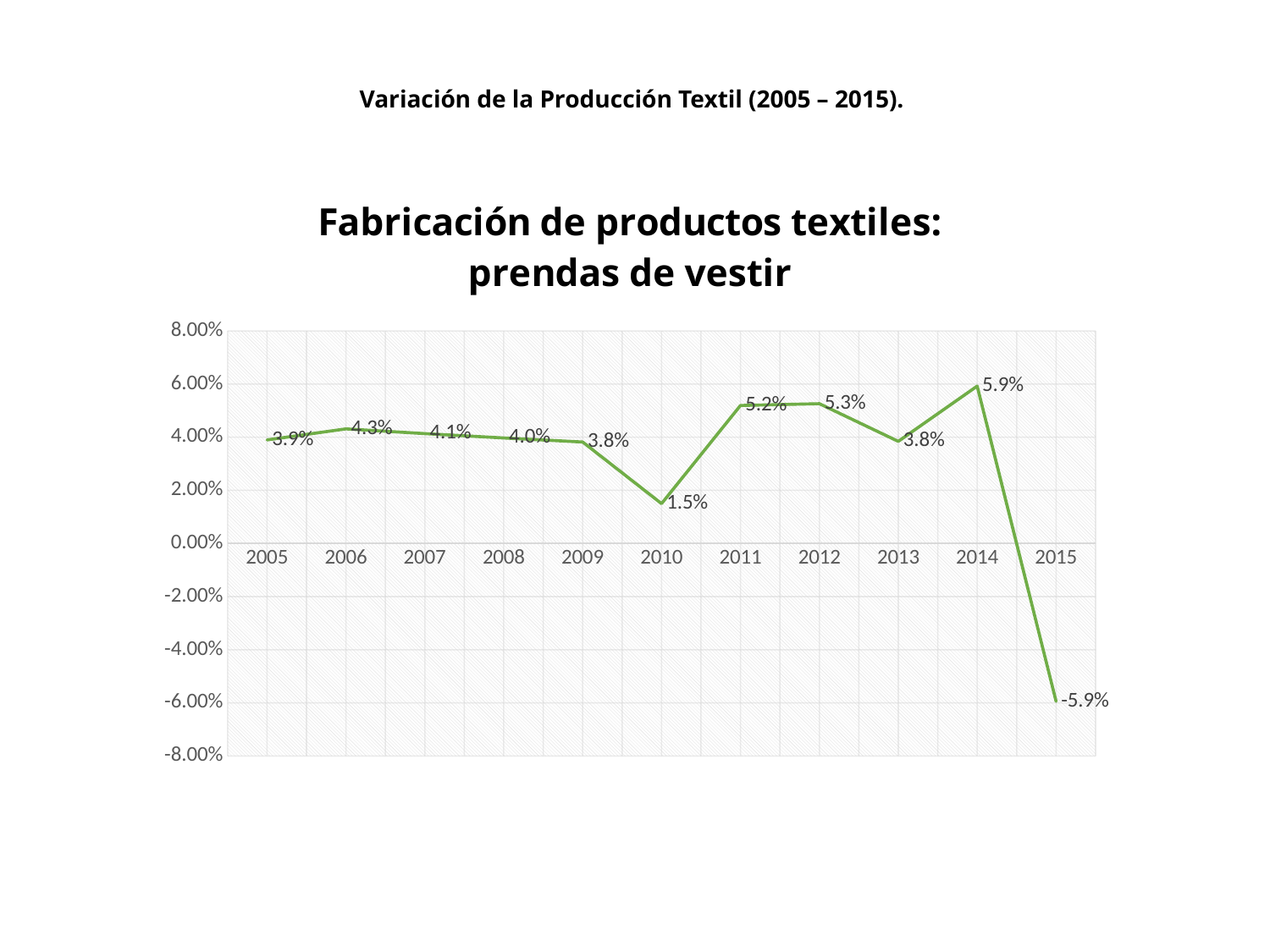
Do the values rise or fall from 2014 to 2015? fall Is the value for 2012 greater or less than 4.00%? greater What is the value for 2010? 1.5% Which year has the highest value? 2014 How many years are plotted on the chart? 11 What is the value for 2006? 4.3% What is the value for 2015? -5.9% Which is larger, the value for 2011 or the value for 2009? 2011 What is the title of the chart? Fabricación de productos textiles: prendas de vestir Which year has the lowest value? 2015 What kind of chart is shown? line chart What is the difference between the values for 2014 and 2013? 2.1%